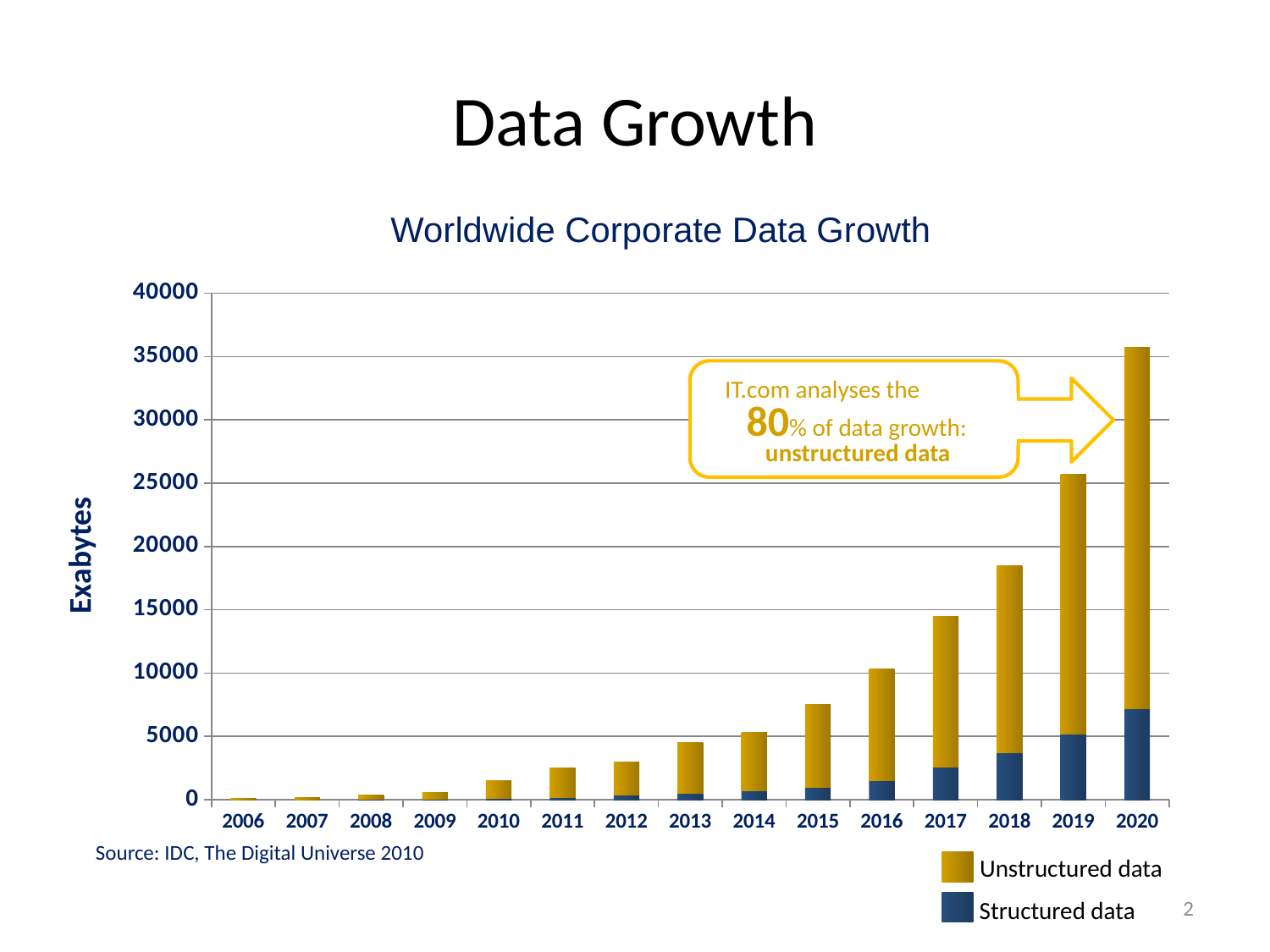
How many years are shown along the x axis of the chart? 15 Is the total bar for 2013 greater or less than 5000? less Which is larger, the total bar for 2019 or the total bar for 2018? 2019 Which year has the tallest bar in the chart? 2020 Is the total bar for 2020 greater or less than 30000? greater How many series does the chart legend list? 2 What is the title of the chart? Worldwide Corporate Data Growth What kind of chart is shown on the slide? bar chart Is the total bar for 2018 greater or less than 20000? less Which year has the shortest bar in the chart? 2006 Do the bar totals rise or fall from 2006 to 2020? rise What is the label on the vertical axis of the chart? Exabytes